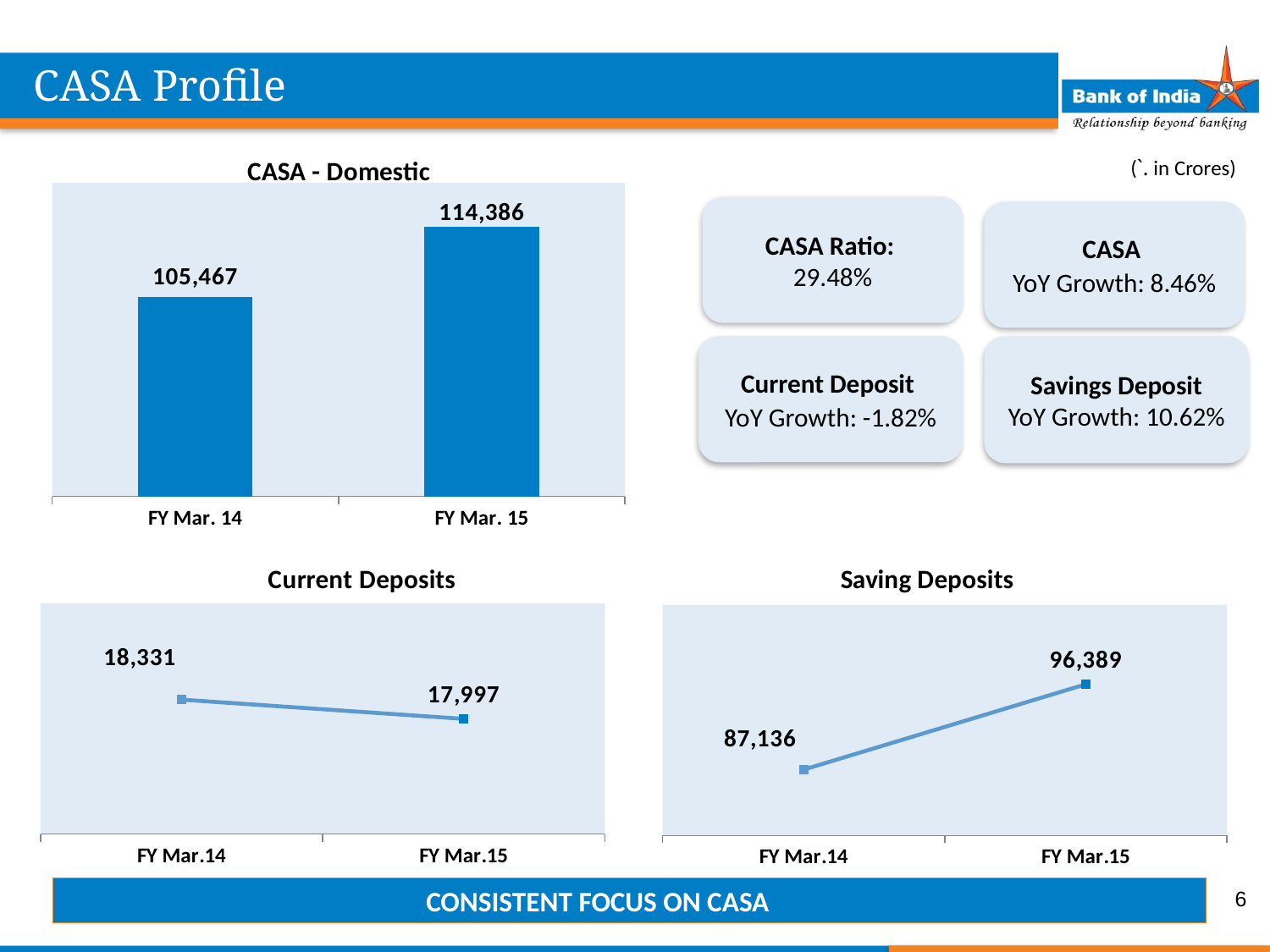
What kind of chart is the Saving Deposits chart? Line chart In the Saving Deposits chart, what is the difference between the FY Mar.15 and FY Mar.14 values? 9,253 In the CASA - Domestic chart, what is the difference between the FY Mar. 15 and FY Mar. 14 values? 8,919 In the Current Deposits chart, what is the value for FY Mar.14? 18,331 In the Saving Deposits chart, what is the value for FY Mar.14? 87,136 In the Saving Deposits chart, what is the value for FY Mar.15? 96,389 In the Current Deposits chart, what is the value for FY Mar.15? 17,997 In the Current Deposits chart, what is the difference between the FY Mar.14 and FY Mar.15 values? 334 In the CASA - Domestic chart, what is the value for FY Mar. 15? 114,386 In the CASA - Domestic chart, what is the value for FY Mar. 14? 105,467 In the Current Deposits chart, do the values rise or fall from FY Mar.14 to FY Mar.15? Fall What kind of chart is the CASA - Domestic chart? Bar chart